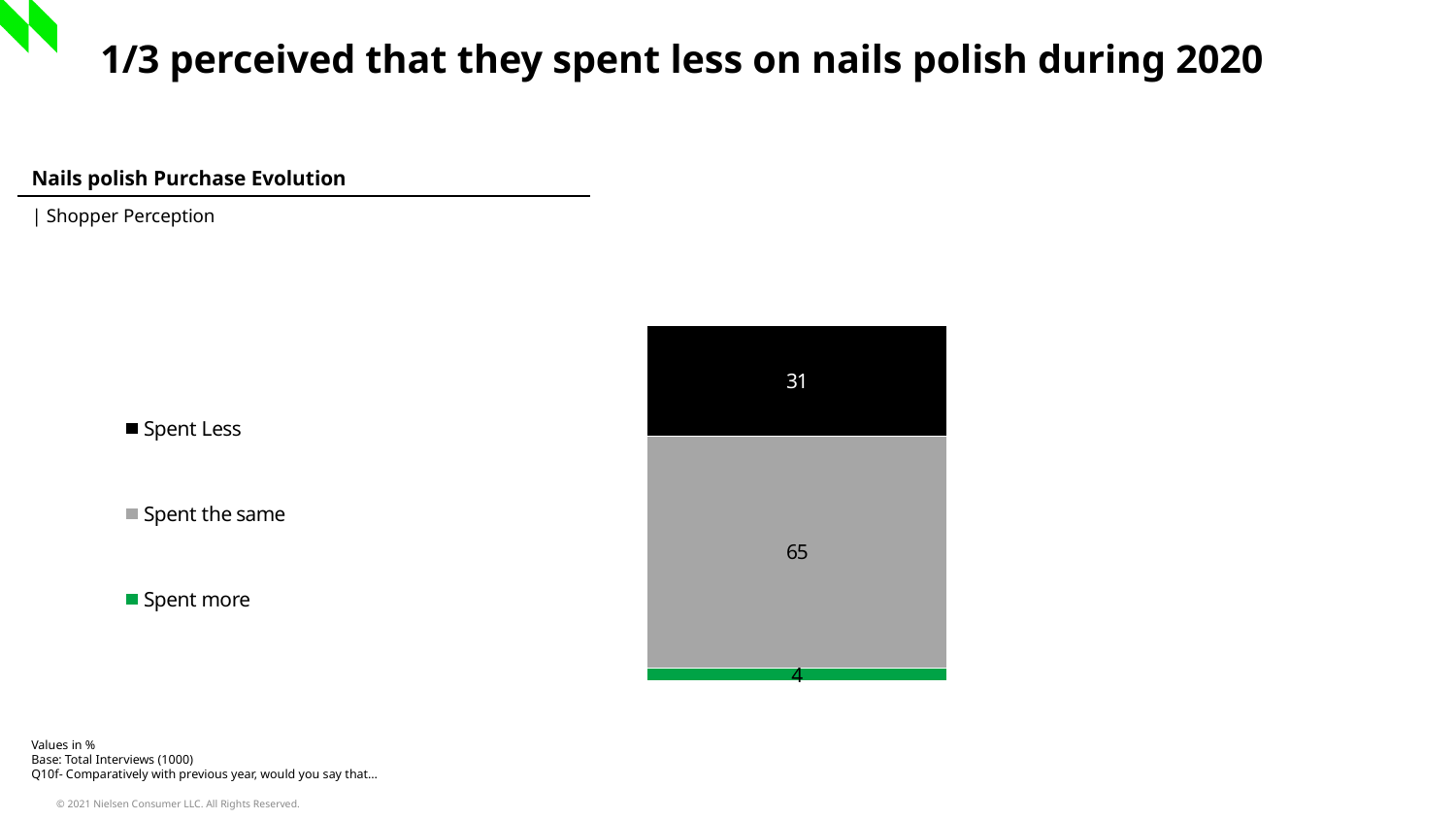
Which segment of the stacked bar has the highest value? Spent the same What value is shown for the 'Spent more' segment of the stacked bar? 4 What is the total of the three segments in the stacked bar? 100 What kind of chart is shown on the slide? Stacked bar chart What value is shown for the 'Spent the same' segment of the stacked bar? 65 How many series does the legend list? 3 Which segment of the stacked bar has the lowest value? Spent more What value is shown for the 'Spent Less' segment of the stacked bar? 31 What is the difference between the 'Spent the same' and 'Spent Less' values? 34 What colour is the 'Spent more' segment in the chart? Green Which is larger, the value for 'Spent Less' or the value for 'Spent more'? Spent Less What is the difference between the 'Spent Less' and 'Spent more' values? 27